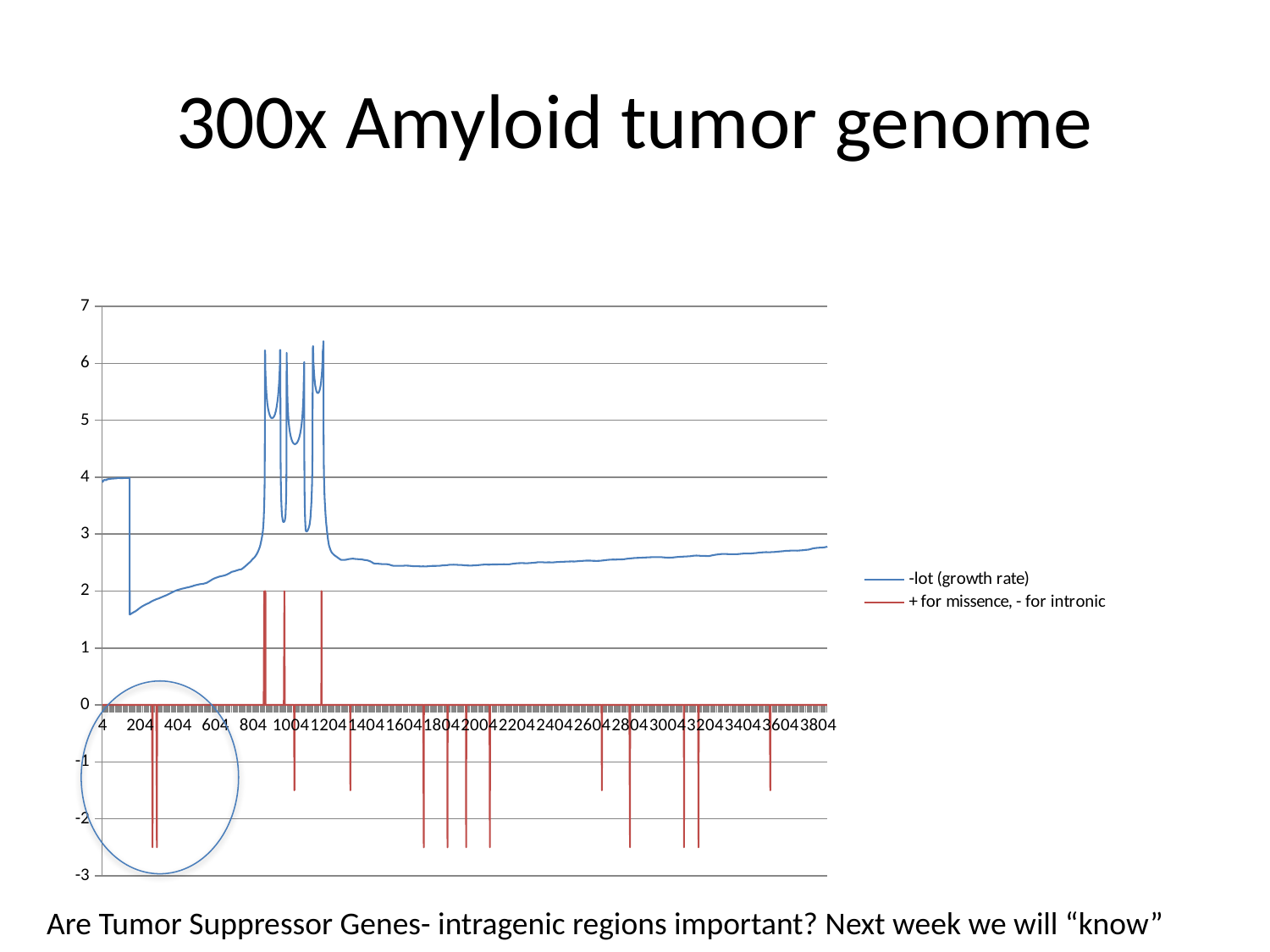
What kind of chart is shown on the slide? line chart How many series does the legend list? 2 Is the value of the -lot (growth rate) series at x = 4 greater or less than 3? greater What is the lowest value shown on the y axis? -3 Is the lowest value of the -lot (growth rate) series greater or less than 2? less Does the -lot (growth rate) series rise or fall between x = 1404 and x = 3804? rise Is the highest peak of the -lot (growth rate) series greater or less than 6? greater What is the title of the chart on the slide? 300x Amyloid tumor genome Which series is drawn in red according to the legend? + for missence, - for intronic Is the -lot (growth rate) value larger at x = 4 or at x = 3804? x = 4